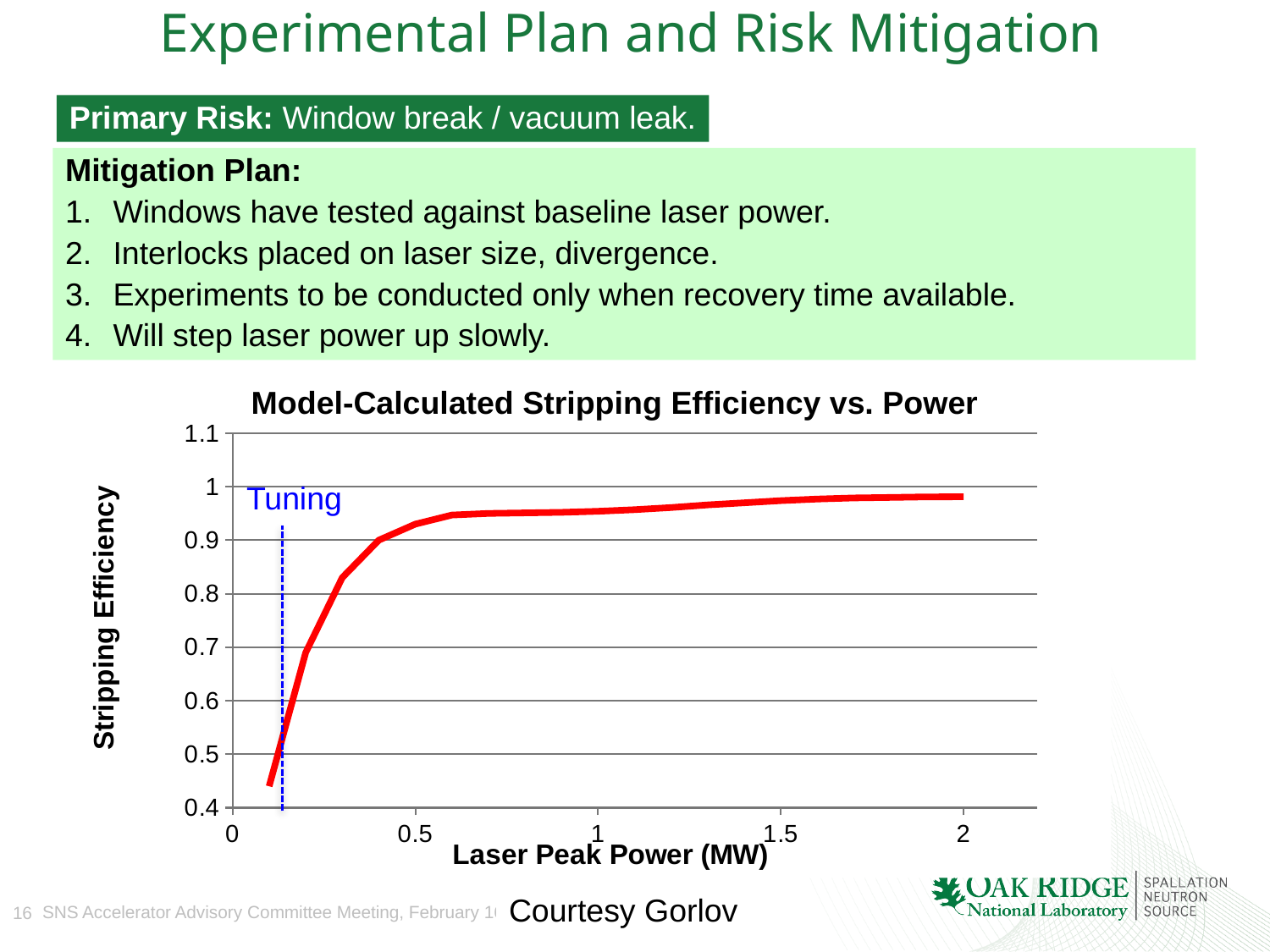
Is the stripping efficiency at a laser peak power of 1 MW greater or less than 0.9? greater Is the stripping efficiency at a laser peak power of 1.5 MW greater or less than 0.9? greater Is the stripping efficiency at a laser peak power of 0.2 MW greater or less than 0.8? less What is the title of the chart? Model-Calculated Stripping Efficiency vs. Power Which has the higher stripping efficiency: a laser peak power of 0.5 MW or 1.5 MW? 1.5 MW Which has the lower stripping efficiency: a laser peak power of 0.2 MW or 1 MW? 0.2 MW What is the highest value shown on the y axis of the chart? 1.1 What kind of chart is shown on the slide? line chart Does the stripping efficiency rise or fall as laser peak power increases along the x axis? rise What is the label of the x axis of the chart? Laser Peak Power (MW)